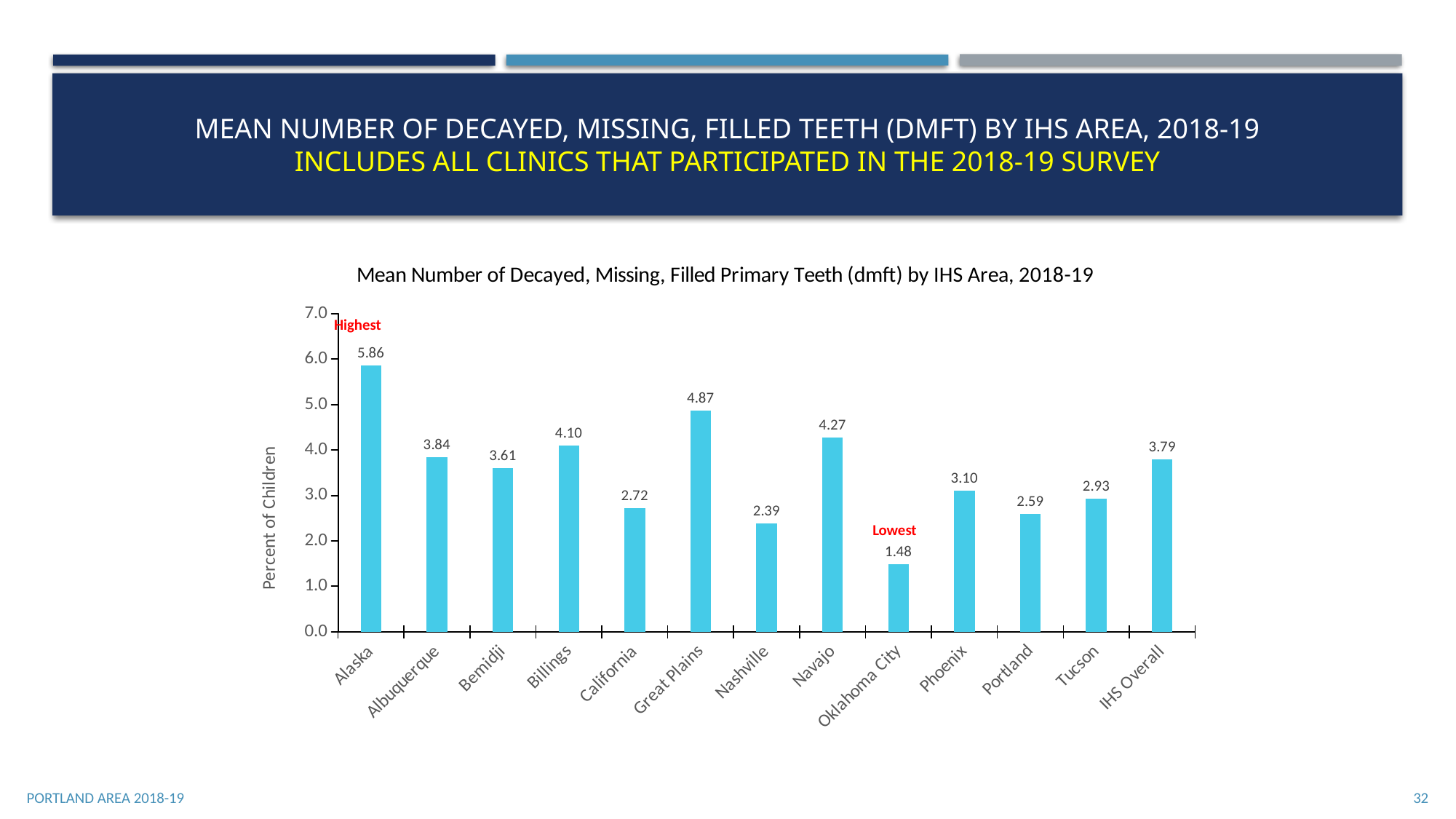
How many categories are shown on the x axis? 13 Which IHS area has the highest mean dmft? Alaska What is the difference between the values for Great Plains and Navajo? 0.60 What is the mean dmft value for Alaska? 5.86 What kind of chart is shown on the slide? Bar chart What is the value shown for IHS Overall? 3.79 Which IHS area has the lowest mean dmft? Oklahoma City What is the mean dmft value for Portland? 2.59 What is the label on the vertical axis of the chart? Percent of Children Which has a higher value, Billings or Albuquerque? Billings What is the difference between the values for Alaska and Oklahoma City? 4.38 Is the value for Phoenix greater or less than 3.0? greater